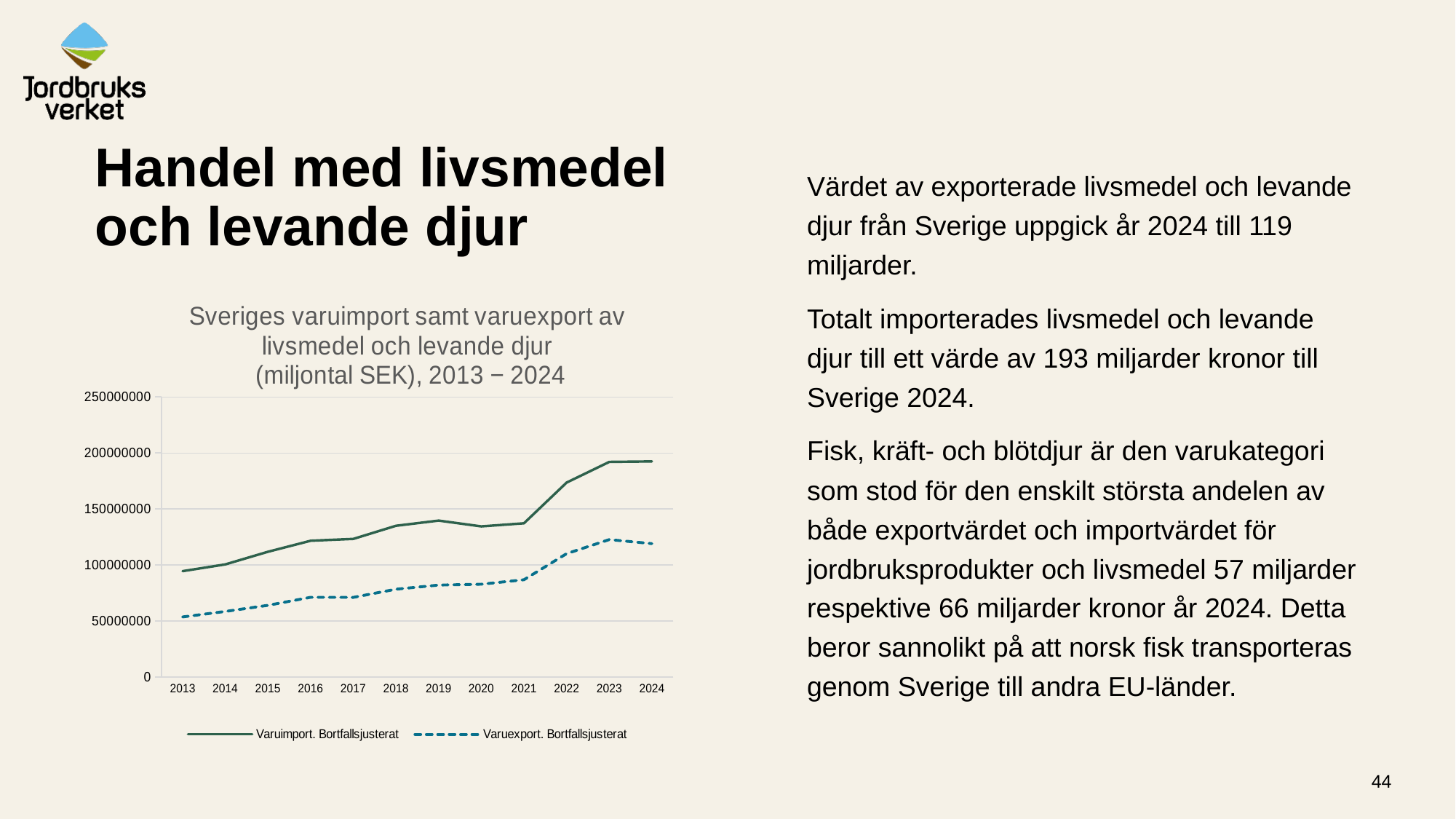
How many years are plotted along the x axis of the chart? 12 How many series does the chart legend list? 2 Which year has the lowest value for Varuimport. Bortfallsjusterat? 2013 Is the value for Varuimport. Bortfallsjusterat in 2024 greater or less than 200000000? less Which year has the lowest value for Varuexport. Bortfallsjusterat? 2013 Is the value for Varuexport. Bortfallsjusterat in 2023 greater or less than 100000000? greater Is the value for Varuimport. Bortfallsjusterat in 2013 greater or less than 100000000? less What kind of chart is shown on the slide? line chart Do the values for Varuimport. Bortfallsjusterat generally rise or fall from 2013 to 2024? rise In 2024, which series has the larger value: Varuimport. Bortfallsjusterat or Varuexport. Bortfallsjusterat? Varuimport. Bortfallsjusterat